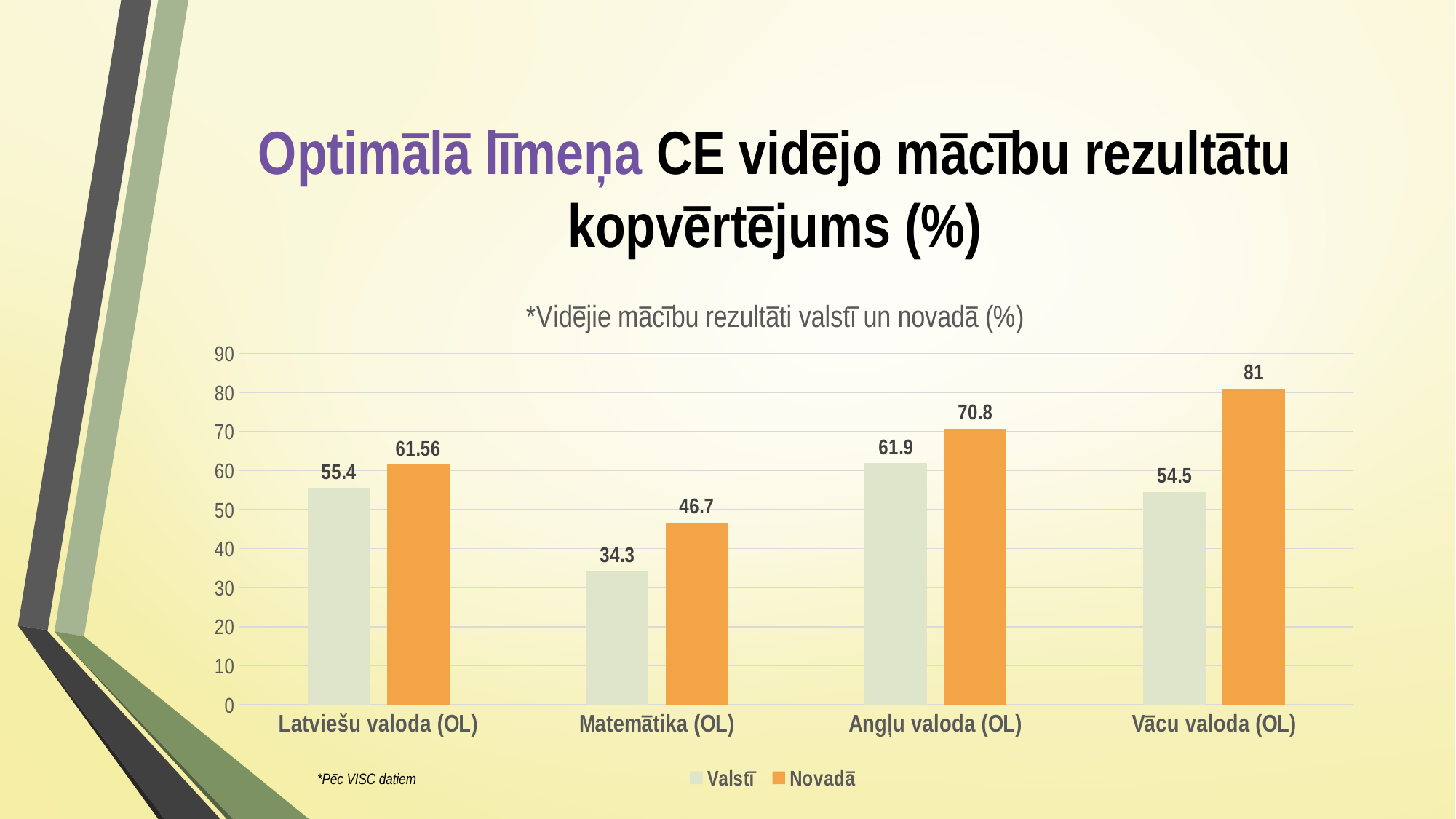
Which category has the lowest Valstī value? Matemātika (OL) What is the Novadā value for Matemātika (OL)? 46.7 Which category has the highest Novadā value? Vācu valoda (OL) What is the difference between the Novadā and Valstī values for Vācu valoda (OL)? 26.5 What kind of chart is shown on the slide? Bar chart What is the difference between the Novadā and Valstī values for Matemātika (OL)? 12.4 How many categories are shown on the x axis? 4 How many series does the legend list? 2 What is the Valstī value for Angļu valoda (OL)? 61.9 Which is larger for Angļu valoda (OL): the Valstī value or the Novadā value? Novadā What is the Novadā value for Vācu valoda (OL)? 81 What is the Valstī value for Latviešu valoda (OL)? 55.4